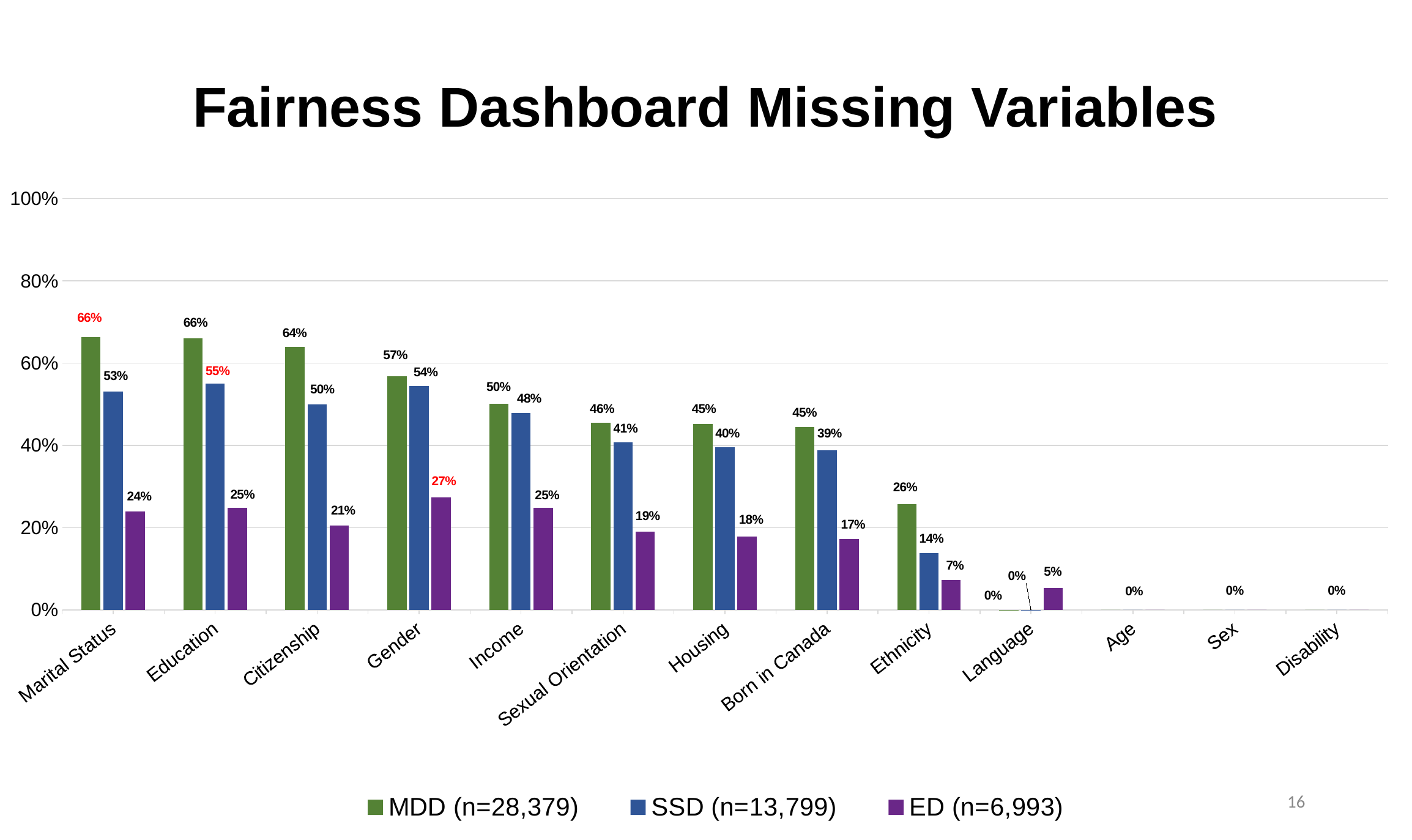
Which is larger, the SSD value for Gender or the SSD value for Income? SSD value for Gender Which category has the highest SSD value? Education What is the difference between the MDD and ED values for Marital Status? 42% How many categories are shown on the x axis? 13 What is the ED value for Language? 5% How many series does the legend list? 3 What is the MDD value for Citizenship? 64% Which category has the highest ED value? Gender What kind of chart is shown on the slide? Bar chart Do the MDD values rise or fall from Marital Status to Disability along the x axis? Fall What is the difference between the MDD and SSD values for Ethnicity? 12% What is the SSD value for Housing? 40%